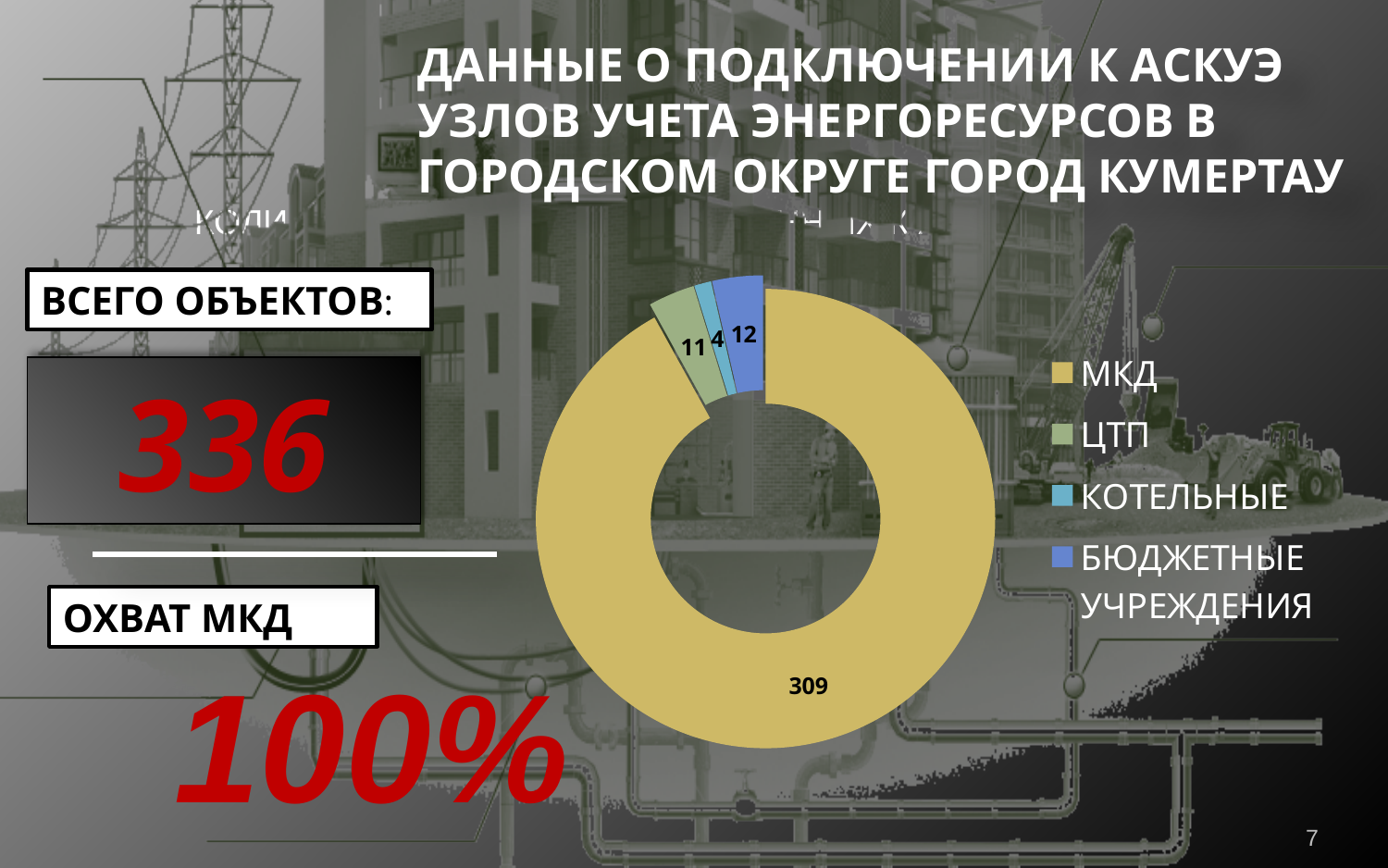
What is the difference between the values for БЮДЖЕТНЫЕ УЧРЕЖДЕНИЯ and ЦТП? 1 How many categories does the chart show? 4 What colour is the МКД segment in the chart? Yellow What kind of chart is shown on the slide? Doughnut (pie) chart What is the difference between the values for МКД and БЮДЖЕТНЫЕ УЧРЕЖДЕНИЯ? 297 What value is shown for ЦТП in the doughnut chart? 11 Which is larger, the value for ЦТП or the value for КОТЕЛЬНЫЕ? ЦТП What value is shown for КОТЕЛЬНЫЕ in the doughnut chart? 4 What value is shown for МКД in the doughnut chart? 309 Which category has the smallest value in the chart? КОТЕЛЬНЫЕ Which category has the largest value in the chart? МКД What value is shown for БЮДЖЕТНЫЕ УЧРЕЖДЕНИЯ in the doughnut chart? 12